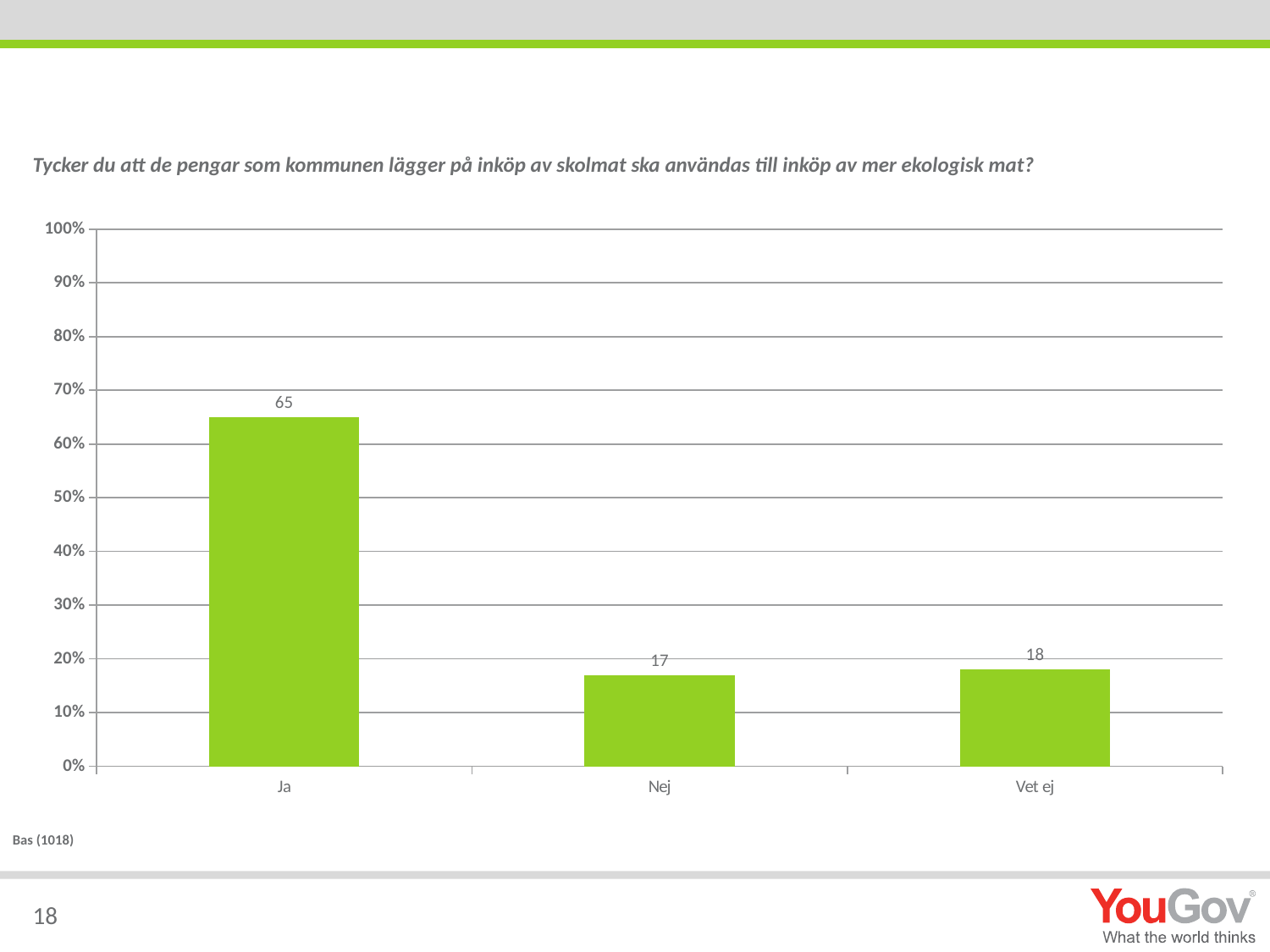
What is the value for Nej? 17 What is the value for Vet ej? 18 What is the base (Bas) shown below the chart? 1018 How many categories are shown on the x axis? 3 Which category has the highest value? Ja Which category has the lowest value? Nej Is the value for Ja greater or less than 60%? greater What is the value for Ja? 65 What kind of chart is shown on the slide? bar chart What is the difference between the values for Vet ej and Nej? 1 Which is larger, the value for Ja or the value for Vet ej? Ja What is the difference between the values for Ja and Nej? 48